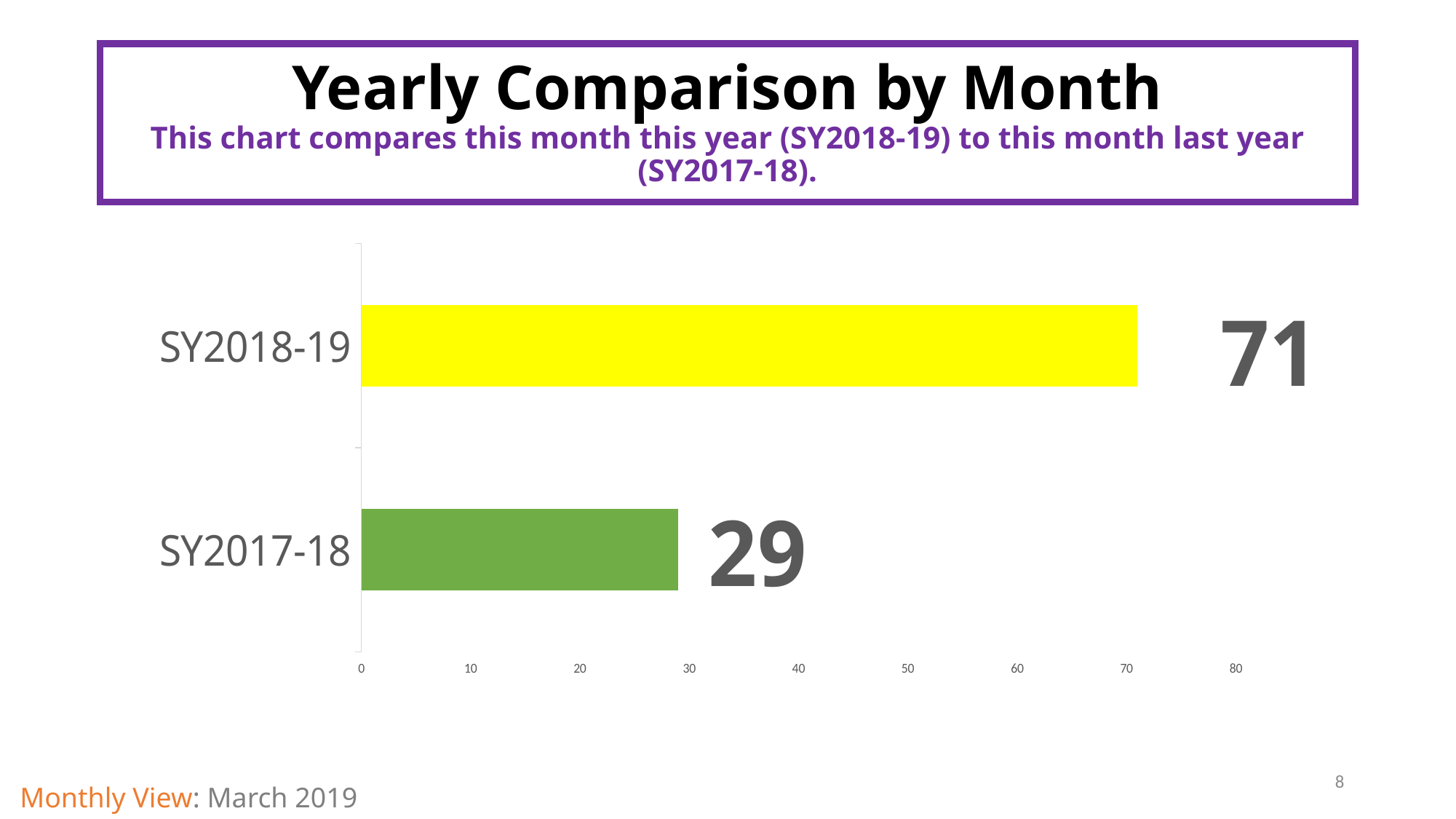
What kind of chart is shown on the slide? bar chart What colour is the bar for SY2017-18? green Is the value for SY2018-19 greater or less than 60? greater What is the difference between the values for SY2018-19 and SY2017-18? 42 Which category has the lowest value? SY2017-18 Which category has the highest value? SY2018-19 What is the value for SY2017-18? 29 Is the value for SY2017-18 greater or less than 40? less Which is larger, the value for SY2018-19 or the value for SY2017-18? SY2018-19 What is the title of the chart? Yearly Comparison by Month How many categories are shown in the chart? 2 What is the value for SY2018-19? 71